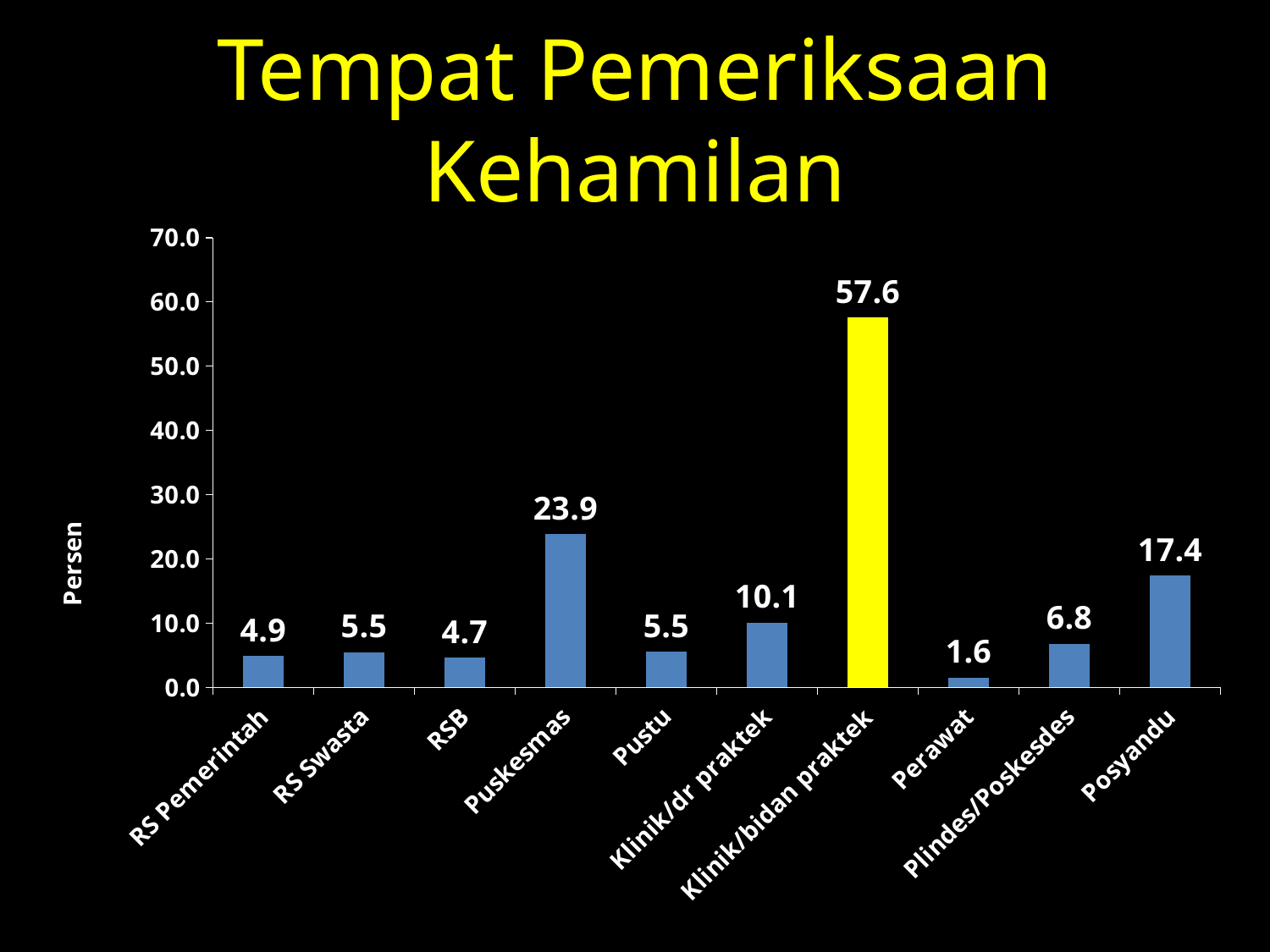
Which category has the lowest value? Perawat How many categories are shown on the x axis? 10 What is the difference between the values for Klinik/bidan praktek and Puskesmas? 33.7 What is the title of the slide? Tempat Pemeriksaan Kehamilan Which is larger, the value for Klinik/dr praktek or the value for Plindes/Poskesdes? Klinik/dr praktek Which category has the highest value? Klinik/bidan praktek What kind of chart is shown on the slide? bar chart Is the value for Posyandu greater or less than 20.0? less What is the value for Puskesmas? 23.9 What is the value for Perawat? 1.6 What is the value for Klinik/bidan praktek? 57.6 What is the value for Posyandu? 17.4